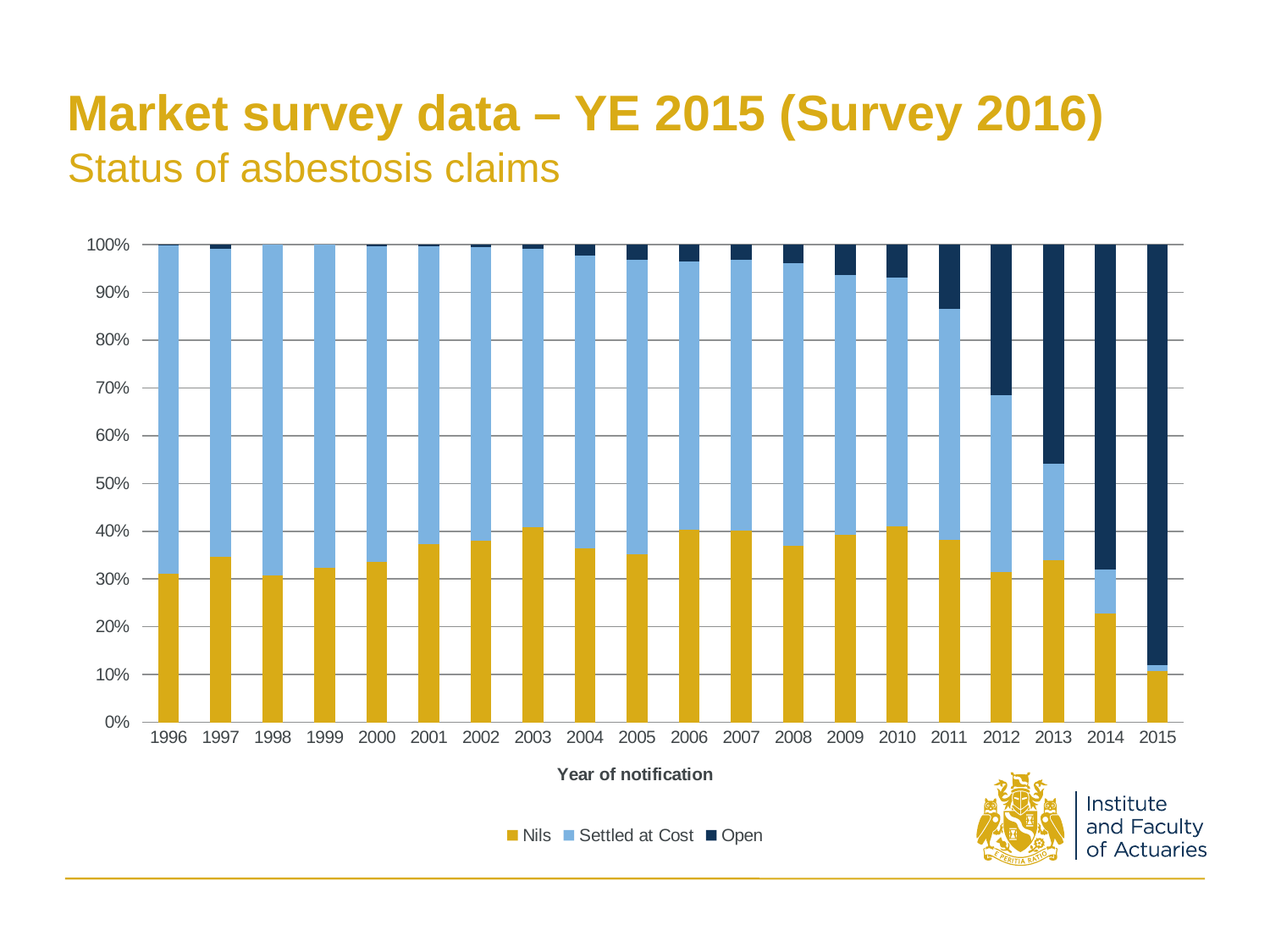
What is the label of the x axis? Year of notification Is the Nils share for 1996 greater or less than 40%? less Which is larger, the Open share for 2013 or the Open share for 2010? 2013 How many years of notification are shown on the x axis? 20 What are the three series named in the legend? Nils, Settled at Cost, Open Does the Open share rise or fall as the year of notification moves from 2009 to 2015? Rise Which year of notification has the largest Open share? 2015 How many series does the legend list? 3 Is the Open share for 2015 greater or less than 80%? greater Is the Settled at Cost share for 1996 greater or less than 60%? greater What kind of chart is shown on the slide? Stacked bar chart Which year of notification has the smallest Nils share? 2015